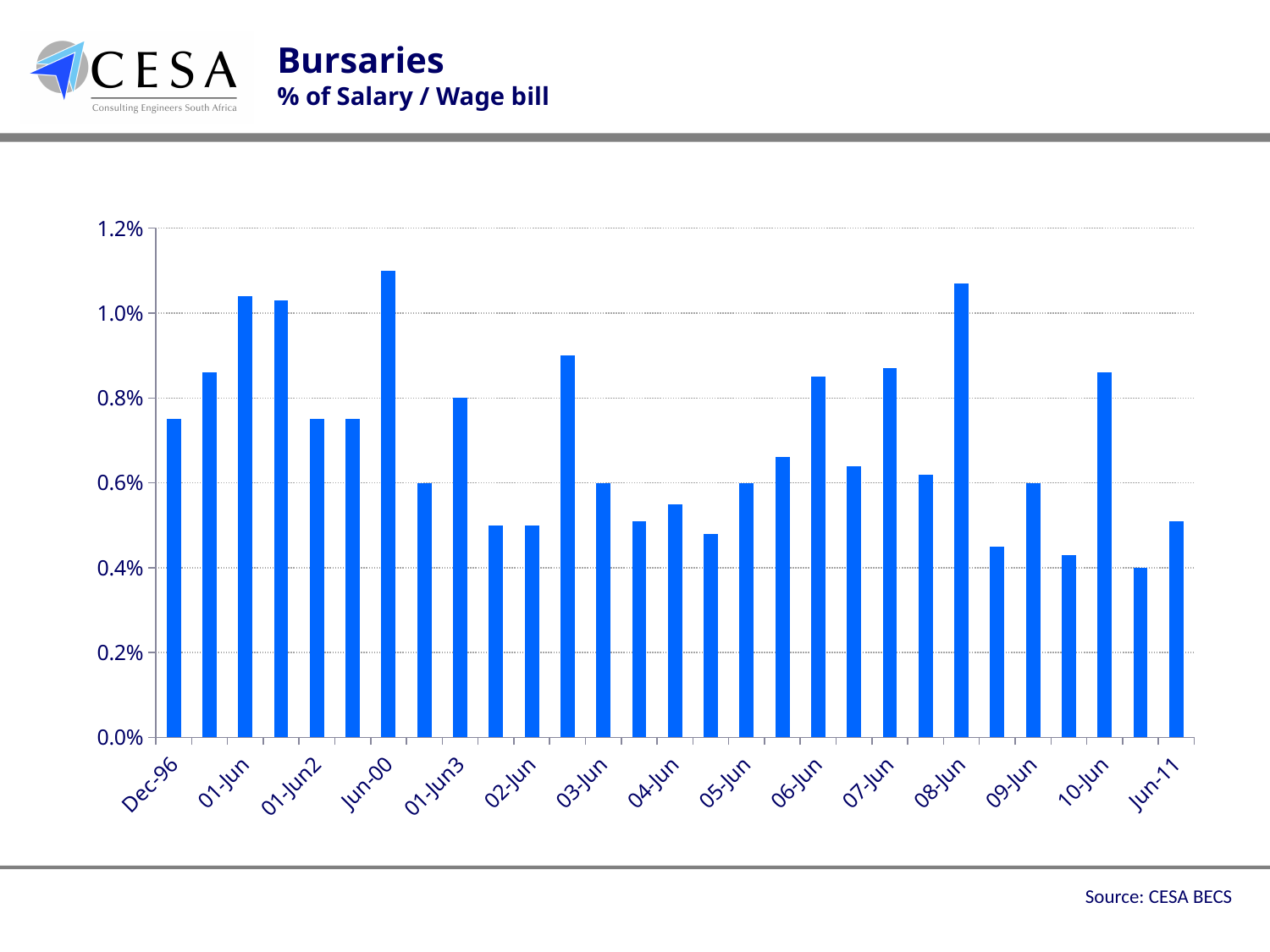
Is the value for 08-Jun greater or less than 1.0%? greater Is the value for Jun-11 greater or less than 0.6%? less What is the title of the chart? Bursaries % of Salary / Wage bill What colour are the bars in the chart? blue Is the value for Jun-00 greater or less than 1.0%? greater Which is larger, the value for Jun-00 or the value for Dec-96? Jun-00 How many x-axis category labels are shown on the chart? 15 Which is larger, the value for 08-Jun or the value for 09-Jun? 08-Jun What kind of chart is shown on the slide? bar chart